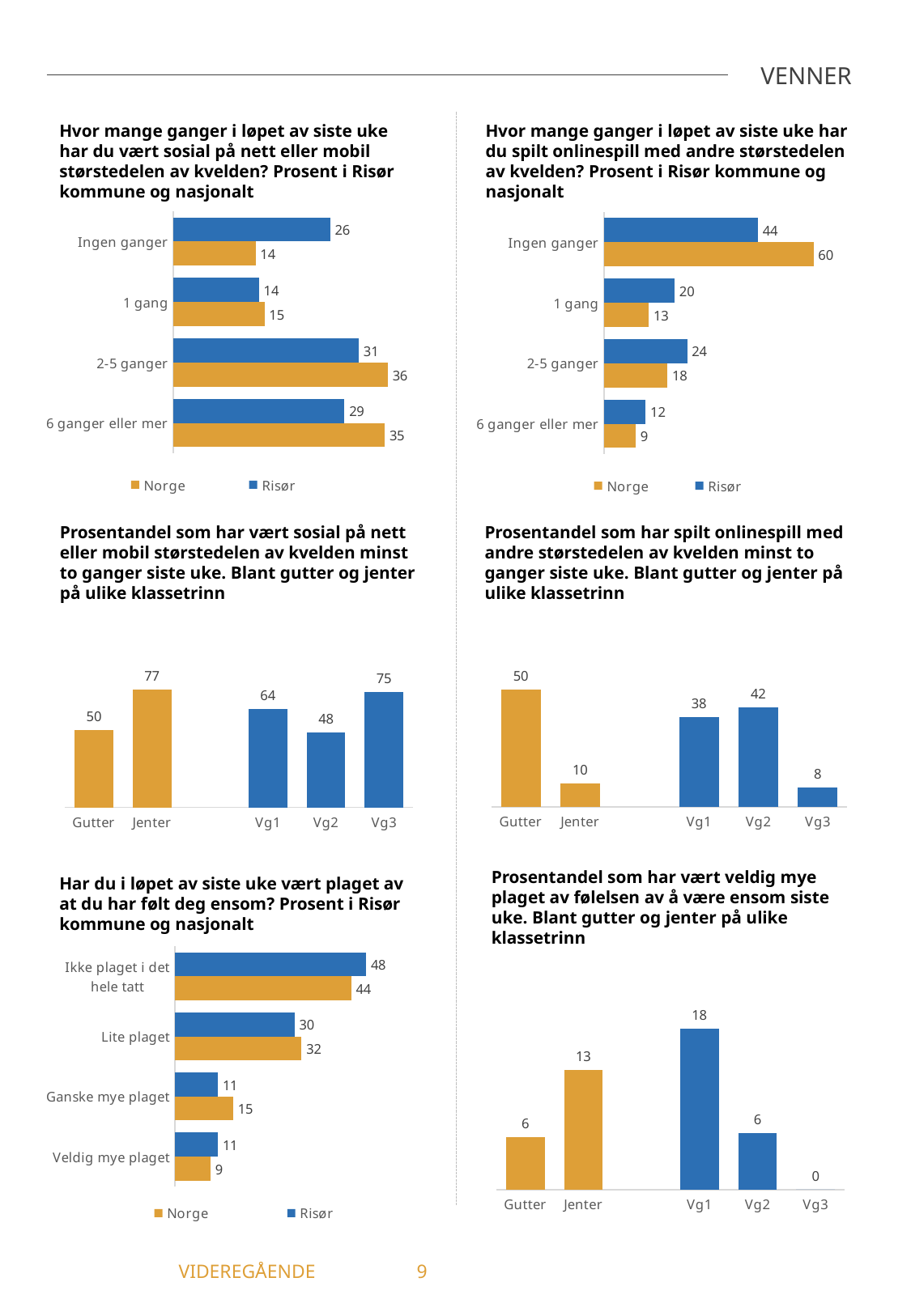
In the top-right chart about playing online games, how many series does the legend list? 2 In the top-left chart about being social online or on mobile, what is the value for Risør in the 'Ingen ganger' category? 26 In the top-left chart about being social online or on mobile, what is the value for Norge in the '2-5 ganger' category? 36 In the top-right chart about playing online games, which category has the highest value for Norge? Ingen ganger In the middle-left chart (social online at least twice last week, by gender and grade), what is the value for Vg2? 48 What kind of chart is the bottom-left chart about feeling lonely? Bar chart In the middle-right chart (played online games at least twice last week, by gender and grade), how many categories are shown? 5 In the middle-right chart (played online games at least twice last week, by gender and grade), which category has the lowest value? Vg3 In the top-right chart about playing online games, what is the difference between Norge and Risør in the 'Ingen ganger' category? 16 In the middle-left chart (social online at least twice last week, by gender and grade), which category has the highest value? Jenter In the bottom-left chart about feeling lonely, which is larger in the 'Ganske mye plaget' category, Norge or Risør? Norge In the bottom-right chart (very much bothered by loneliness, by gender and grade), what is the value for Vg1? 18